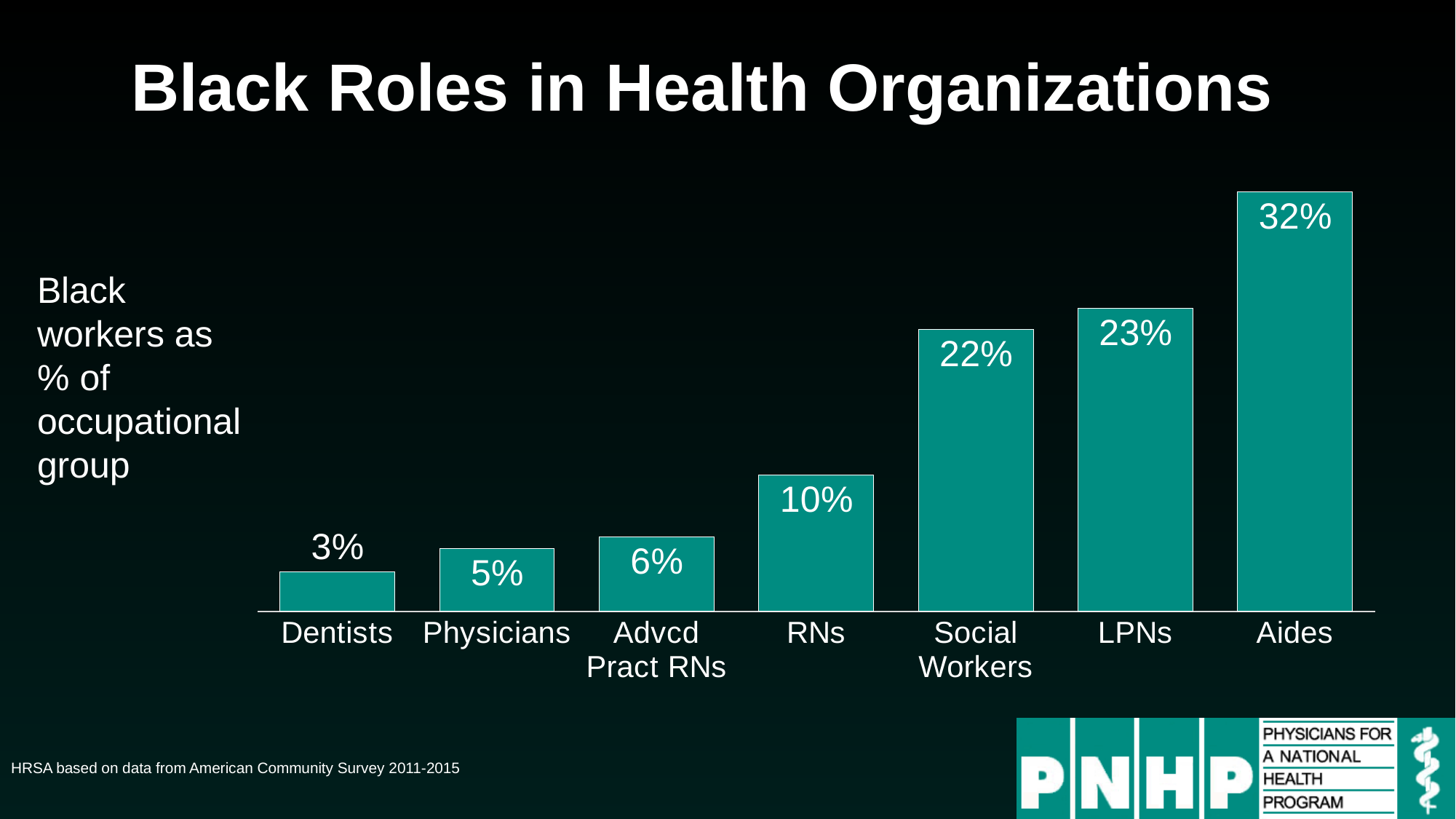
Do the values rise or fall moving from left to right across the categories? Rise What is the value shown for RNs? 10% What is the value shown for Social Workers? 22% What is the title of the slide containing the chart? Black Roles in Health Organizations What is the difference between the values for LPNs and Social Workers? 1% What is the difference between the values for Aides and Dentists? 29% Which occupational group has the lowest percentage of Black workers? Dentists What percentage of Aides are Black workers? 32% Which occupational group has the highest percentage of Black workers? Aides Which is larger, the value for Physicians or the value for Advcd Pract RNs? Advcd Pract RNs How many occupational groups are shown in the chart? 7 What kind of chart is shown on the slide? Bar chart